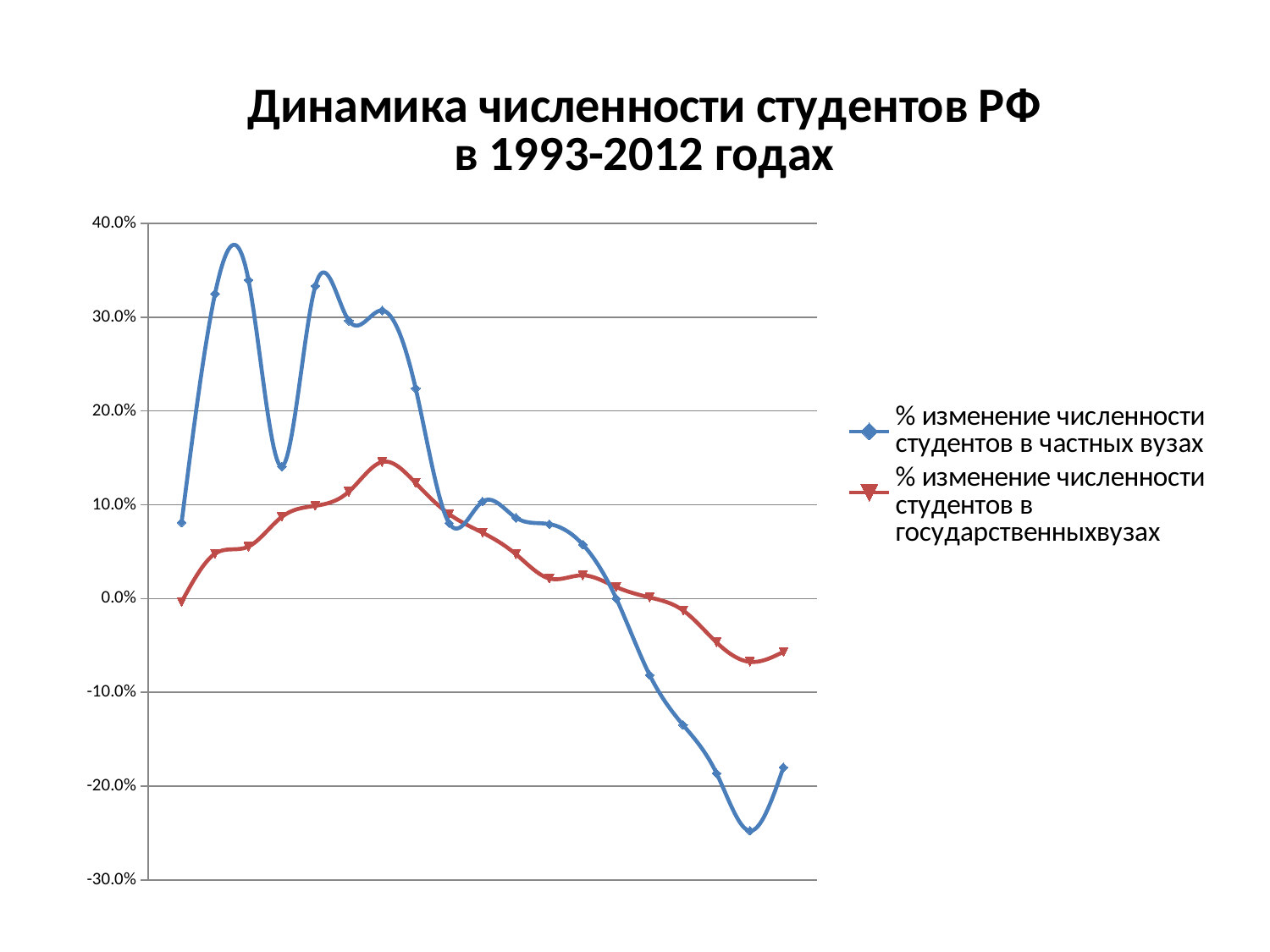
Overall, does the private universities series rise or fall from the left of the chart to the right? fall Is the last point of the private universities series greater or less than -10.0%? less How many series does the legend list? 2 What is the title of the chart? Динамика численности студентов РФ в 1993-2012 годах Which series reaches the higher maximum value, the private universities series or the state universities series? % изменение численности студентов в частных вузах What kind of chart is shown on the slide? line chart Is the highest value of the private universities series greater or less than 30.0%? greater Is the highest value of the state universities series greater or less than 20.0%? less Which series is drawn in red with triangle markers? % изменение численности студентов в государственныхвузах Which series drops to the lower minimum value, the private universities series or the state universities series? % изменение численности студентов в частных вузах